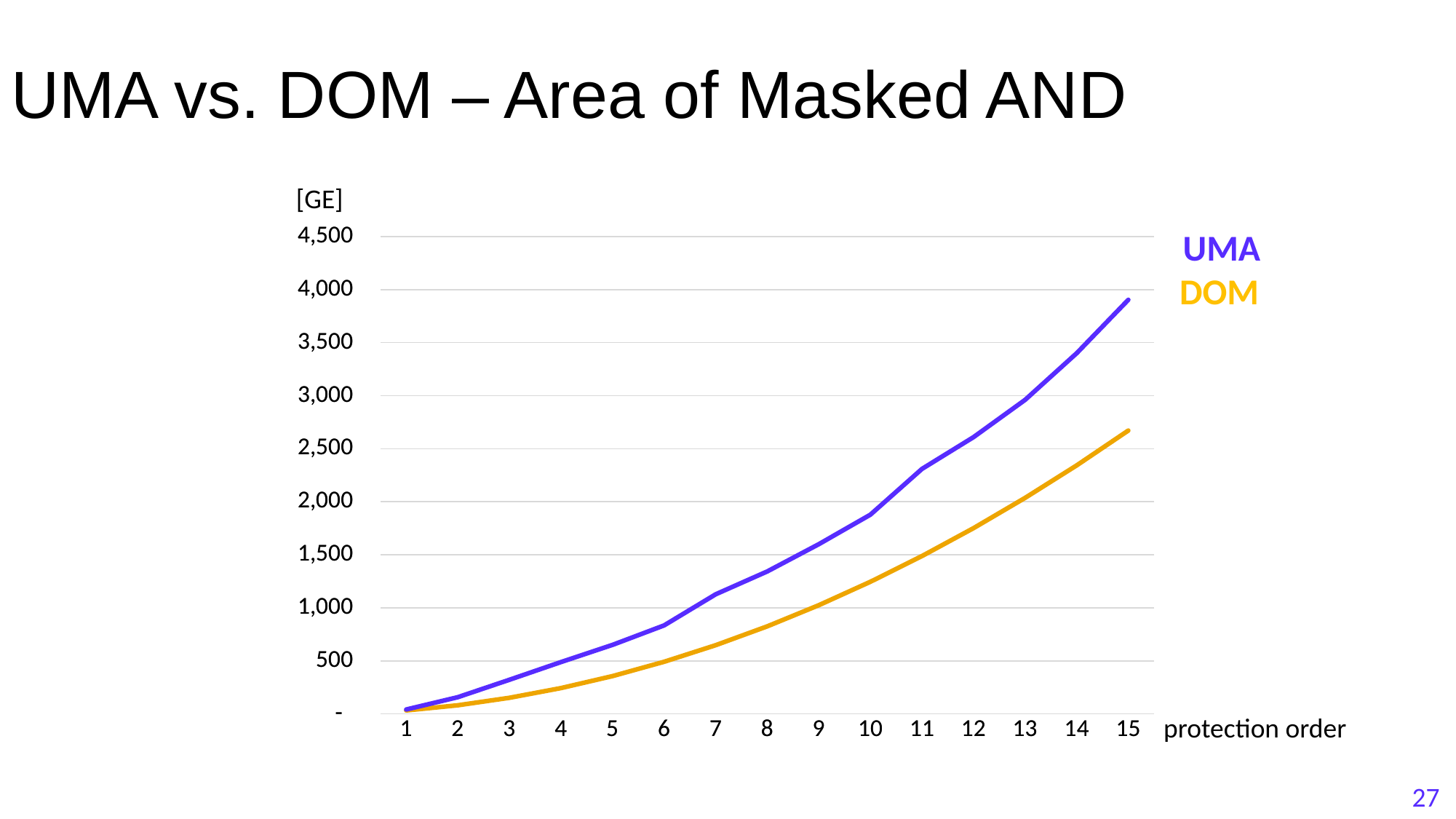
How many series does the legend list? 2 What colour is the DOM line? orange Which series has the lower area at protection order 10, UMA or DOM? DOM Is the DOM value at protection order 15 greater or less than 2,500? greater What unit is shown on the y axis? [GE] How many protection orders are plotted along the x axis? 15 What kind of chart is shown on the slide? line chart Do the UMA values rise or fall as the protection order increases? rise Which series has the higher area at protection order 15, UMA or DOM? UMA Is the UMA value at protection order 15 greater or less than 3,500? greater Is the DOM value at protection order 12 greater or less than 2,000? less